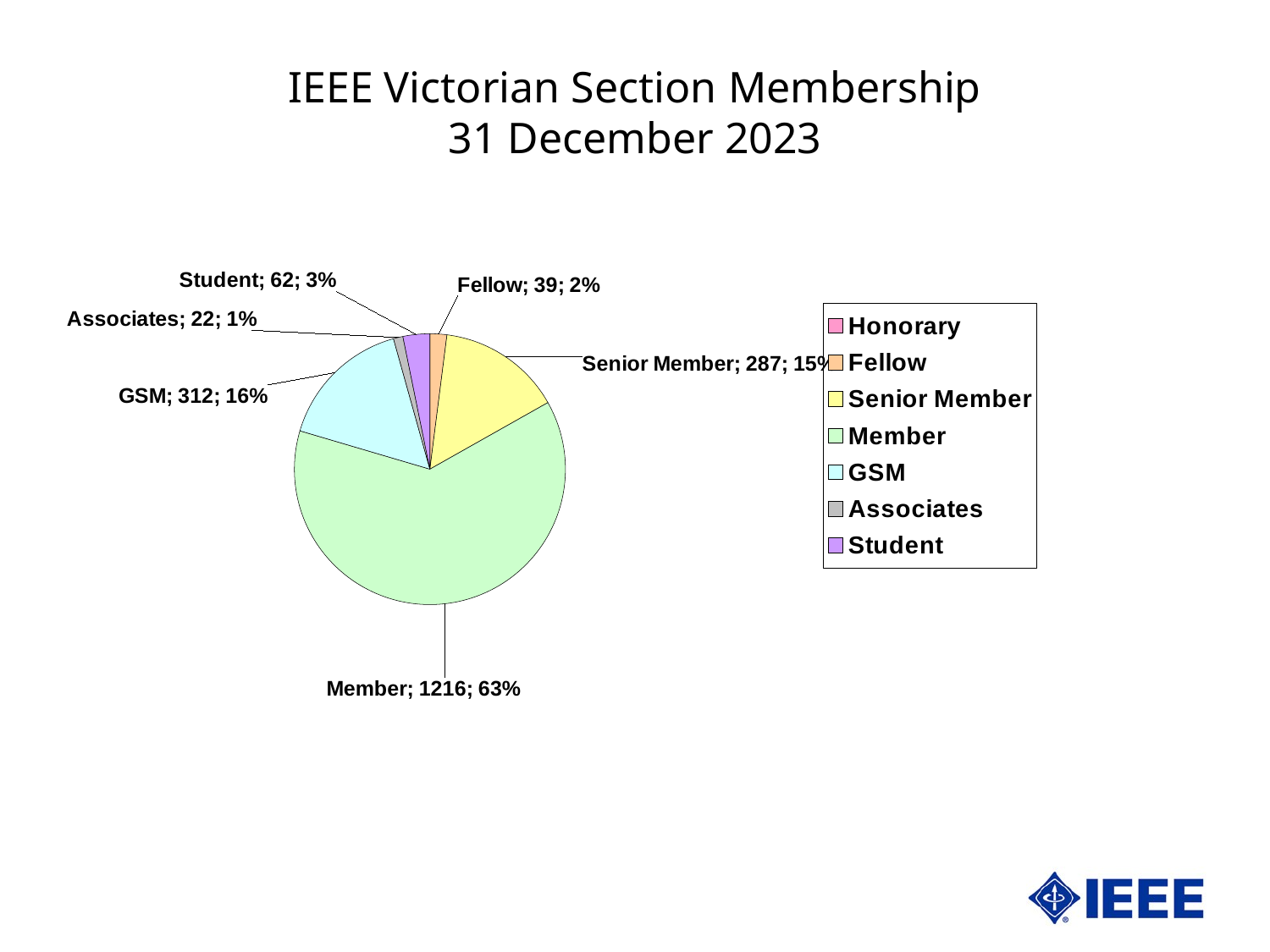
Which category has the largest slice of the pie? Member What is the difference between the GSM value and the Senior Member value? 25 What kind of chart is shown on the slide? pie chart What is the value shown for Senior Member? 287 What is the value shown for Fellow? 39 What share of the pie does the GSM slice represent? 16% Which of the labelled slices has the smallest value? Associates What is the value shown for GSM? 312 Which is larger, the Student value or the Fellow value? Student How many members are in the Member category? 1216 What share of the pie does the Member slice represent? 63% How many entries does the legend list? 7